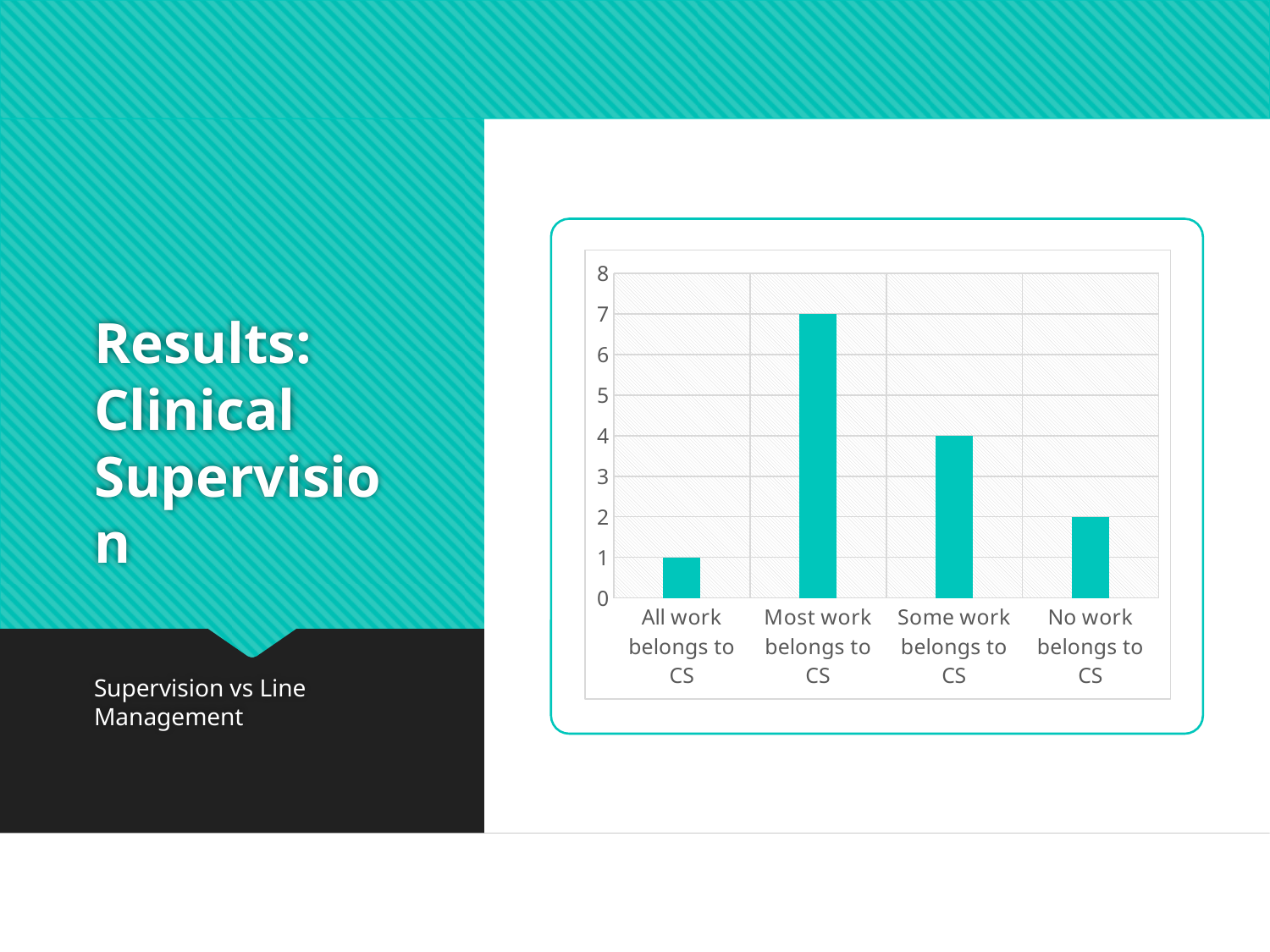
Which is larger, the value for "Some work belongs to CS" or the value for "No work belongs to CS"? Some work belongs to CS How many categories are shown on the x axis of the chart? 4 What is the value for "Most work belongs to CS"? 7 What is the value for "No work belongs to CS"? 2 What kind of chart is shown on the slide? bar chart What is the maximum value shown on the vertical axis of the chart? 8 Is the value for "Most work belongs to CS" greater or less than 5? greater What is the value for "Some work belongs to CS"? 4 What is the difference between the values for "Most work belongs to CS" and "Some work belongs to CS"? 3 What is the value for "All work belongs to CS"? 1 Which category has the highest value? Most work belongs to CS Which category has the lowest value? All work belongs to CS